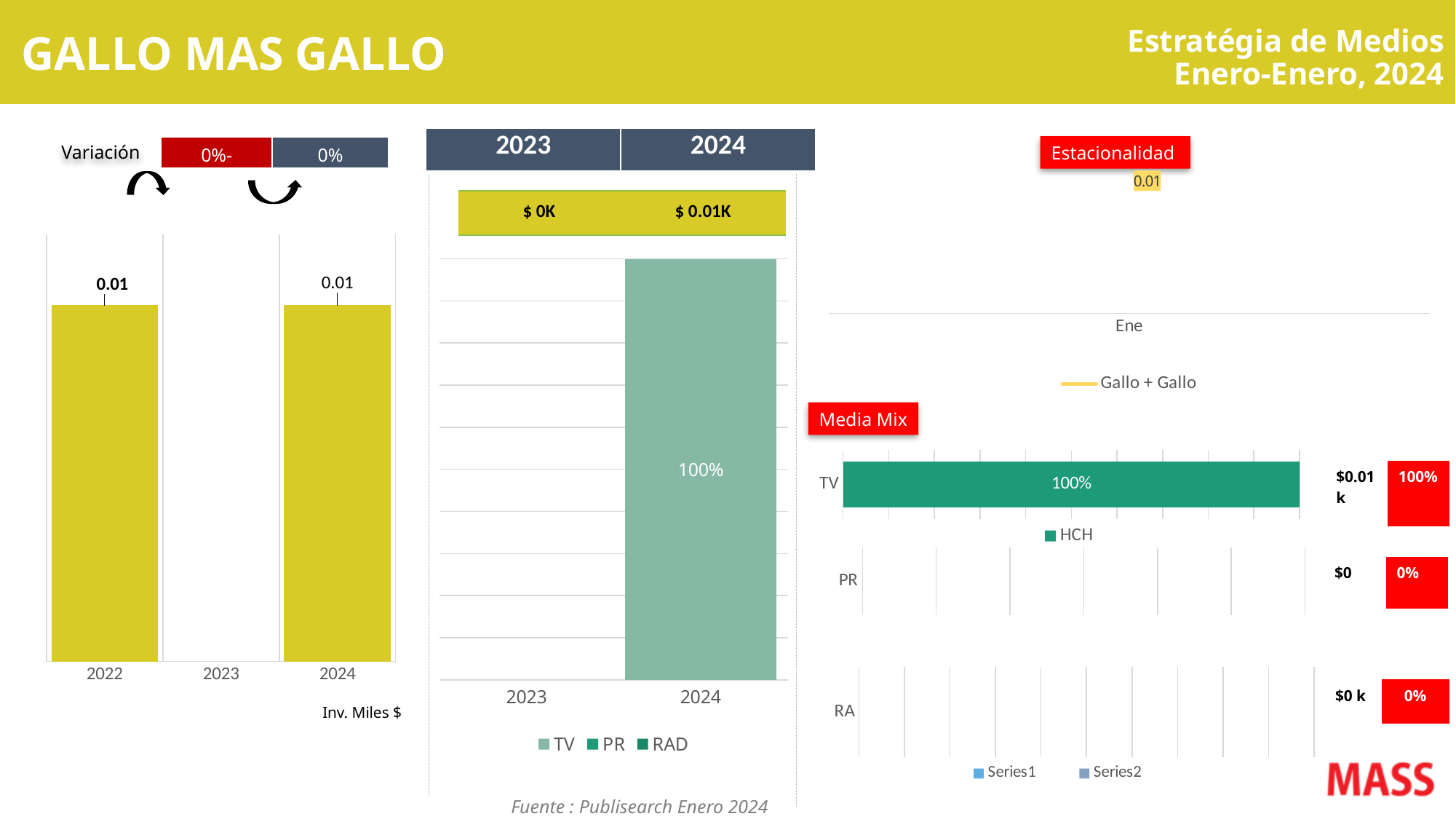
In the middle chart, what value is shown in the header box for 2024? $ 0.01K In the middle stacked bar chart, which series does the legend list first? TV In the Media Mix chart, what percentage is shown for TV? 100% In the left bar chart (Inv. Miles $), what is the value for 2024? 0.01 In the left bar chart (Inv. Miles $), how many year categories are shown on the x axis? 3 In the middle stacked bar chart, how many series does the legend list? 3 In the Estacionalidad chart, what is the legend entry? Gallo + Gallo In the left bar chart (Inv. Miles $), what is the value for 2022? 0.01 In the Estacionalidad chart, what value is shown for Ene? 0.01 In the Media Mix chart, which category has the highest share: TV, PR or RA? TV What kind of chart is the left chart labelled Inv. Miles $? bar chart In the middle stacked bar chart, what percentage is shown for TV in 2024? 100%